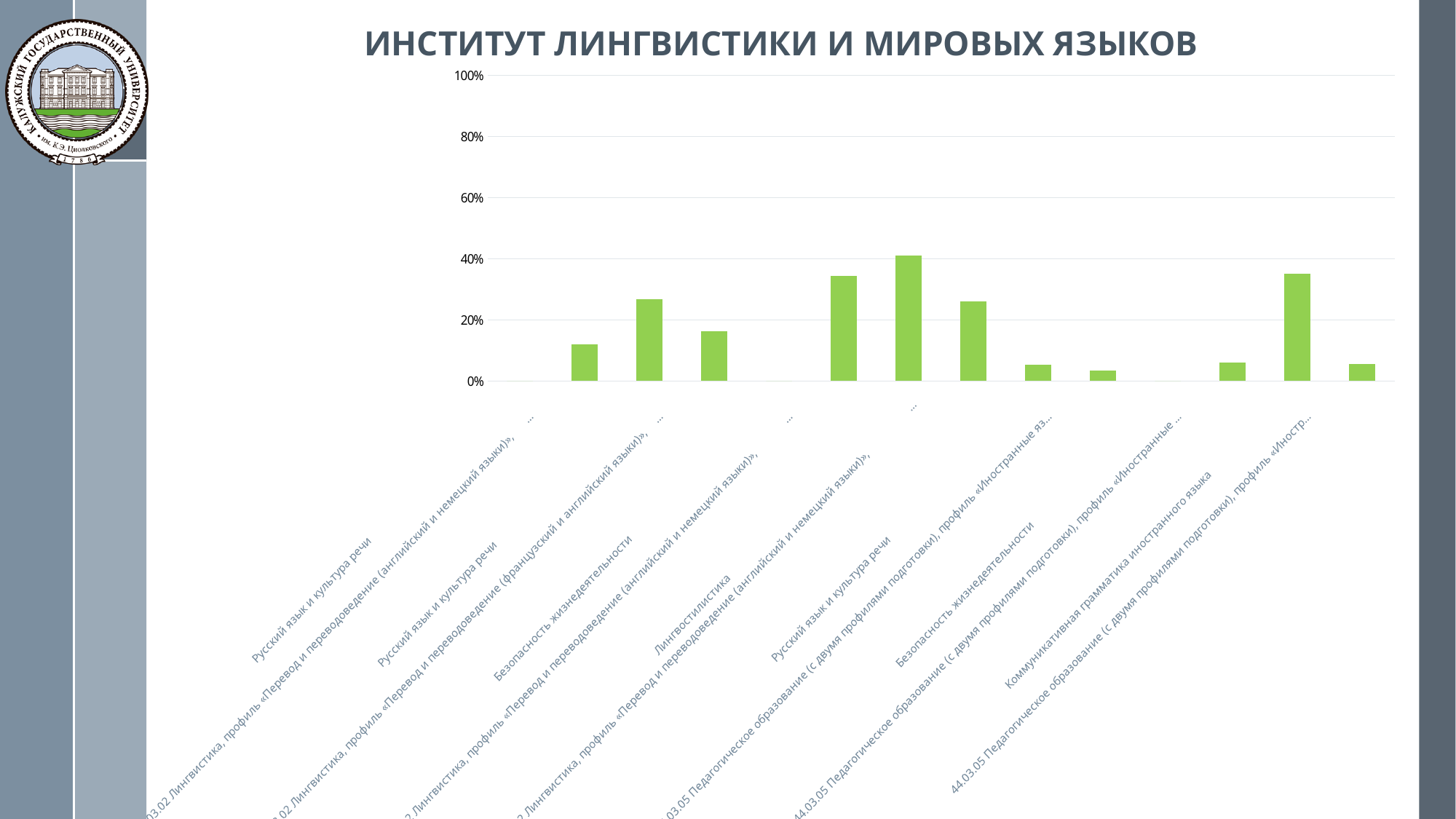
Which is larger: the value for Лингвостилистика or the value for Коммуникативная грамматика иностранного языка? Лингвостилистика What is the title of the slide with the chart? ИНСТИТУТ ЛИНГВИСТИКИ И МИРОВЫХ ЯЗЫКОВ Which category has the highest bar in the chart? Лингвостилистика Is the value for Коммуникативная грамматика иностранного языка greater or less than 40%? less Is the value for Коммуникативная грамматика иностранного языка greater or less than 20%? greater Is the value for Лингвостилистика greater or less than 20%? greater What kind of chart is shown on the slide? bar chart What is the highest value shown on the vertical axis of the chart? 100%